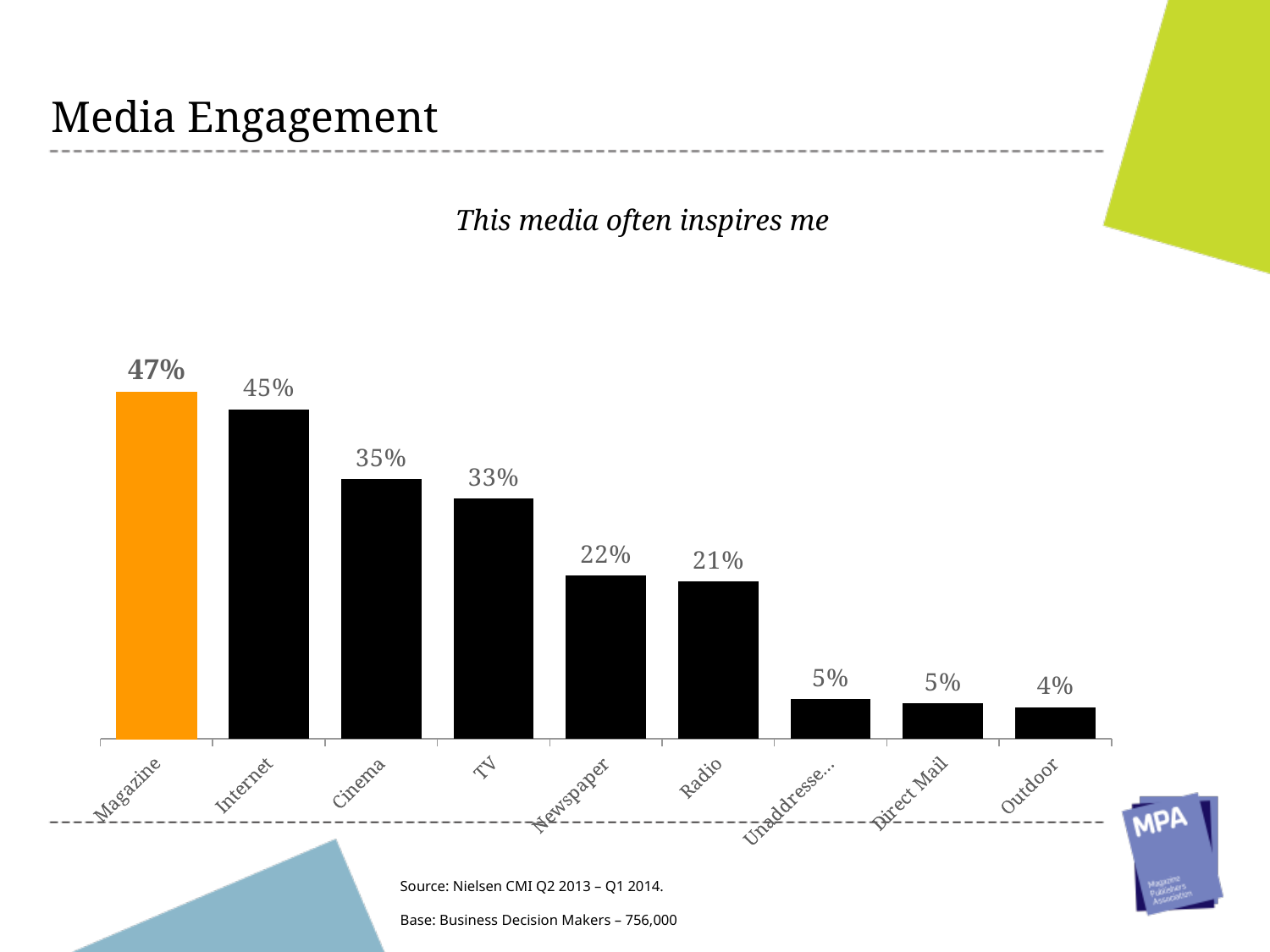
Which category has the lowest value? Outdoor Which is larger, the value for Cinema or the value for TV? Cinema What is the difference between the values for TV and Newspaper? 11% What is the value for Magazine? 47% How many categories are shown in the chart? 9 What is the value for Direct Mail? 5% What is the title of the chart? This media often inspires me What is the difference between the values for Magazine and Internet? 2% What kind of chart is shown on the slide? Bar chart What is the value for Cinema? 35% Which category has the highest value? Magazine What is the value for Radio? 21%